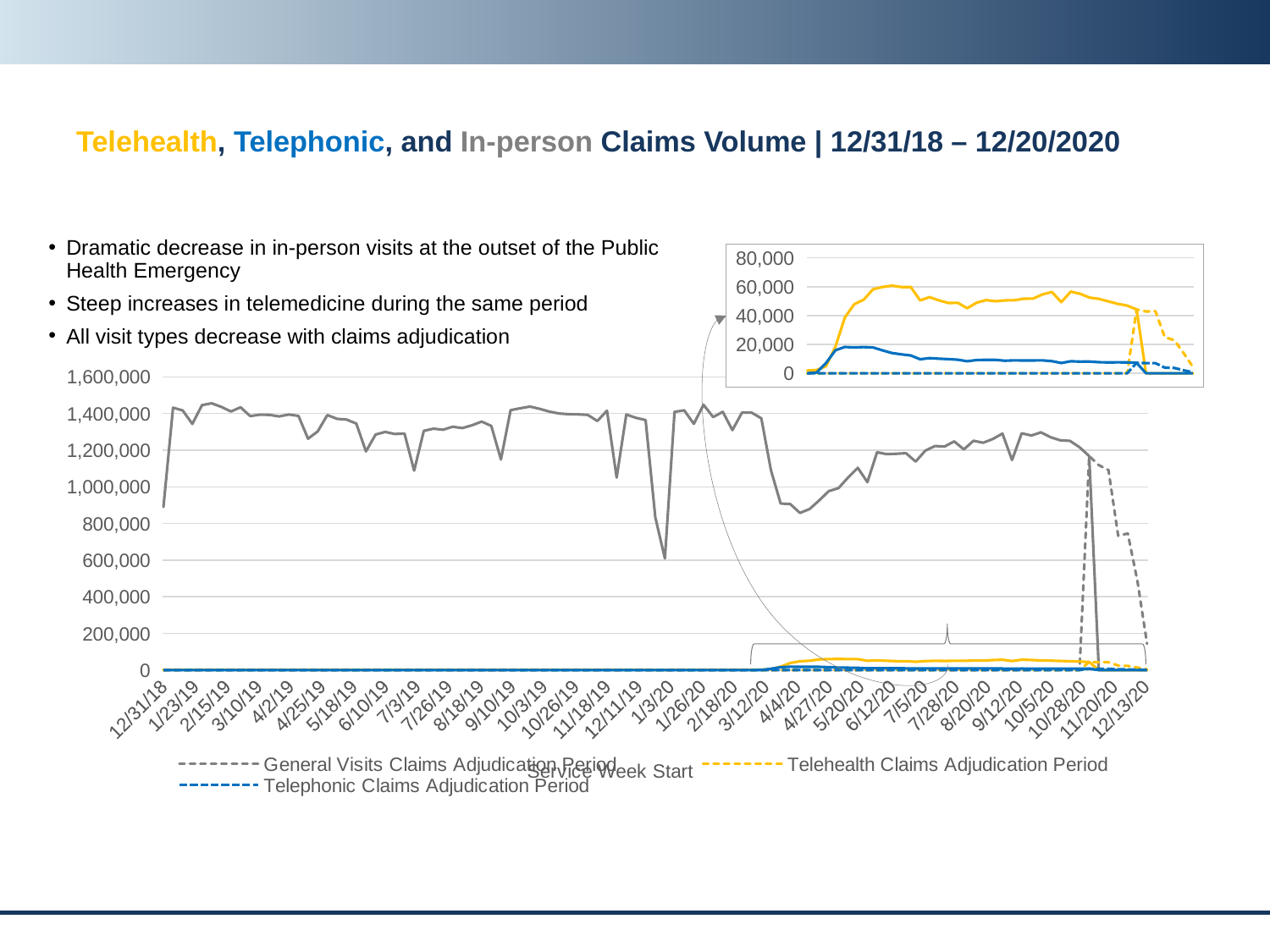
What kind of chart is the main chart on the slide? line chart What is the highest value shown on the y axis of the main chart? 1,600,000 In the main chart, do General Visits rise or fall between 3/12/20 and 4/4/20? fall In the main chart, is the General Visits value at the dip near 1/3/20 greater or less than 800,000? less In the main chart, is the General Visits value at 12/31/18 greater or less than 1,000,000? less In the inset chart at the top right, is the peak Telehealth value greater or less than 40,000? greater What is the title of the x axis of the main chart? Service Week Start In the main chart, which series has the highest values across the period? General Visits In the inset chart at the top right, which series is higher, Telehealth or Telephonic? Telehealth How many series does the legend of the main chart list? 3